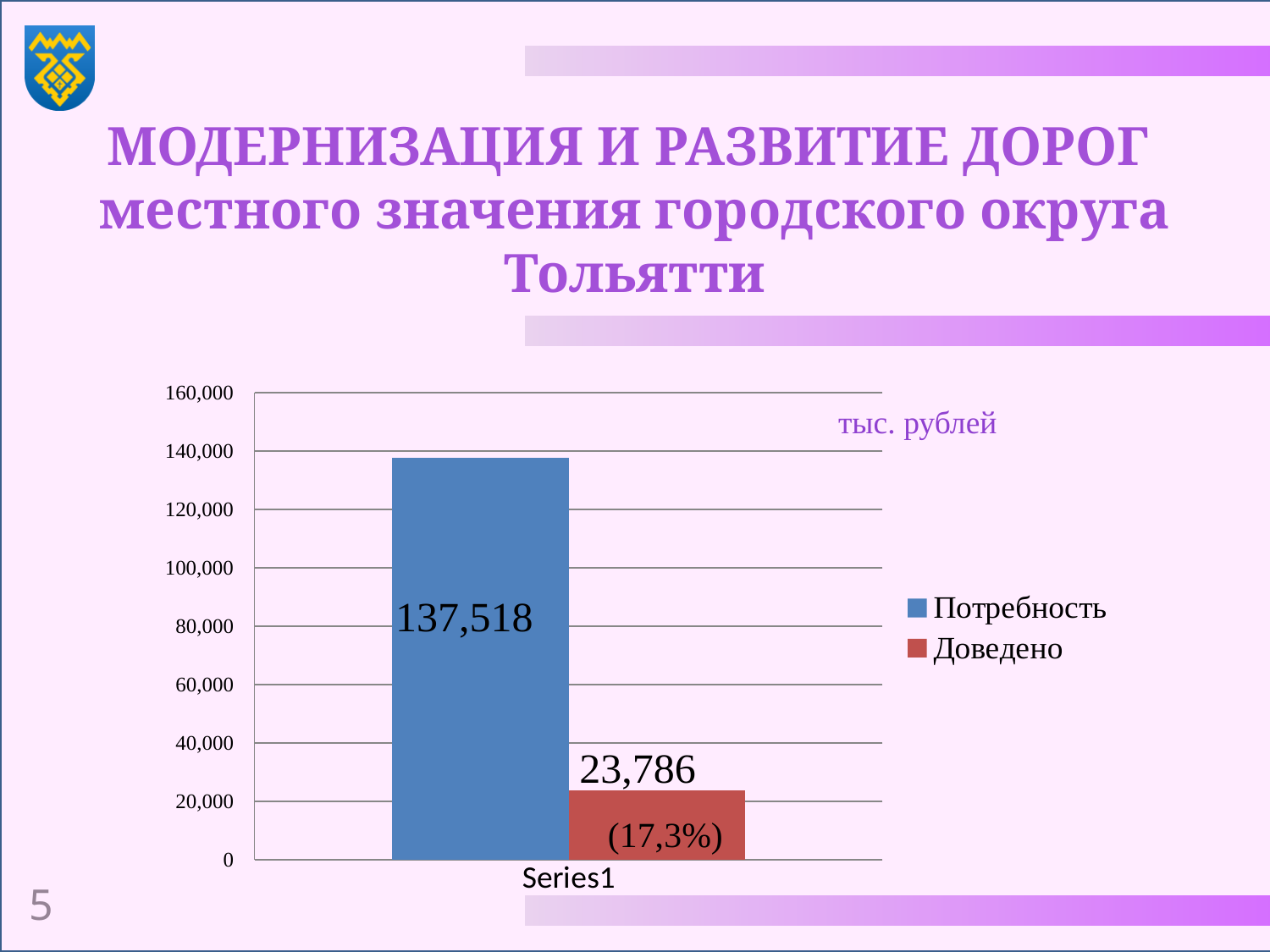
Is the value for Доведено greater or less than 40,000? less What is the value of the Потребность bar? 137,518 What colour is the Потребность bar? blue Is the value for Потребность greater or less than 120,000? greater How many series does the legend list? 2 Which series has the higher value, Потребность or Доведено? Потребность What percentage is shown on the Доведено bar? (17,3%) Which series has the lowest value? Доведено What unit label is shown on the chart? тыс. рублей What is the difference between the Потребность and Доведено values? 113,732 What kind of chart is shown on the slide? bar chart What is the value of the Доведено bar? 23,786